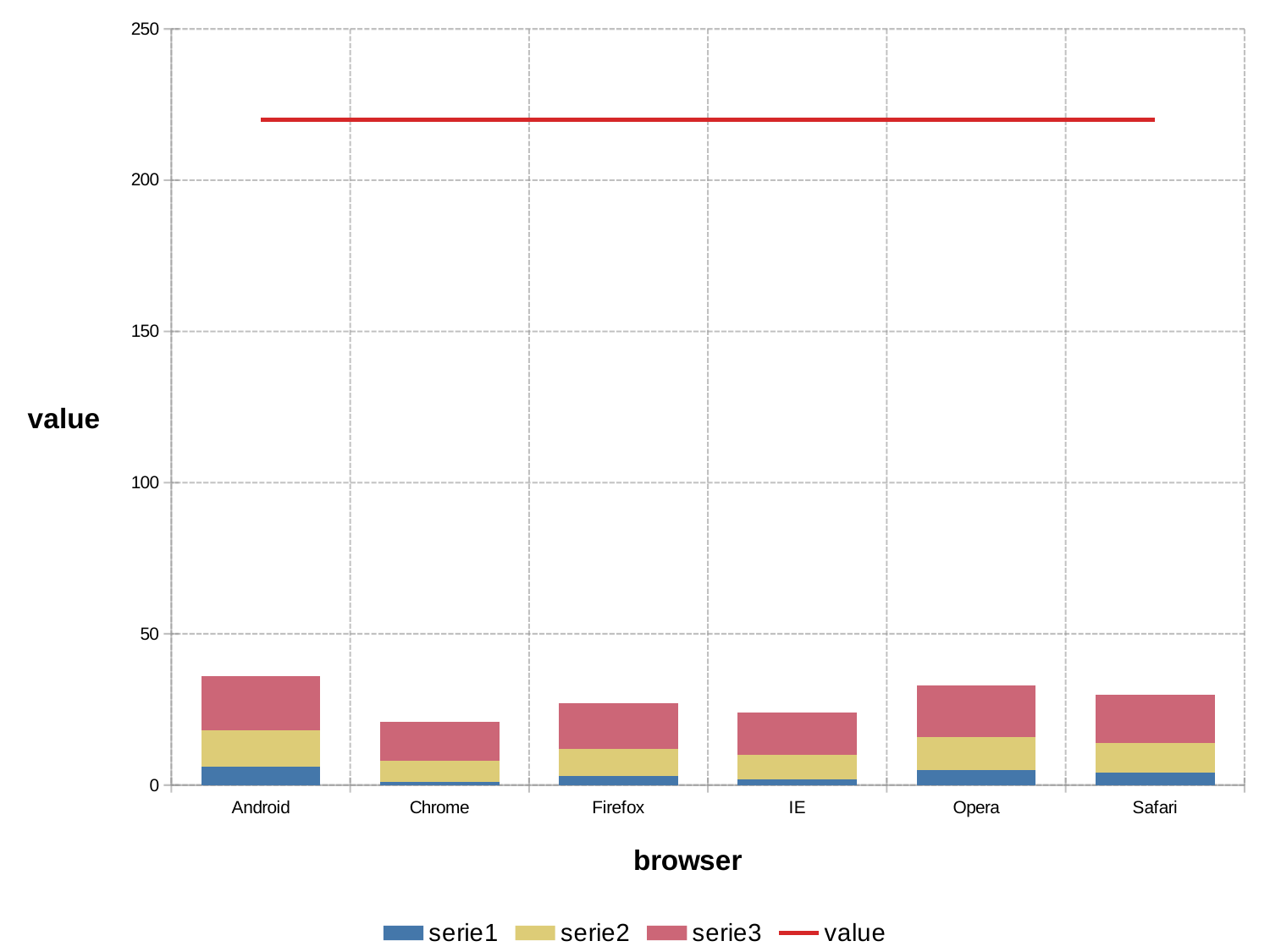
Which has the larger total stacked bar, Android or IE? Android What is the title of the x axis? browser What kind of chart is shown on the slide? stacked bar chart with a line Is the total stacked value for Android greater or less than 50? less Is the total stacked value for Chrome greater or less than 50? less How many entries does the legend list? 4 How many browser categories are shown on the x axis? 6 Which has the larger total stacked bar, Android or Chrome? Android Which has the larger total stacked bar, Chrome or Opera? Opera Is the red 'value' line greater or less than 250? less What is the title of the y axis? value